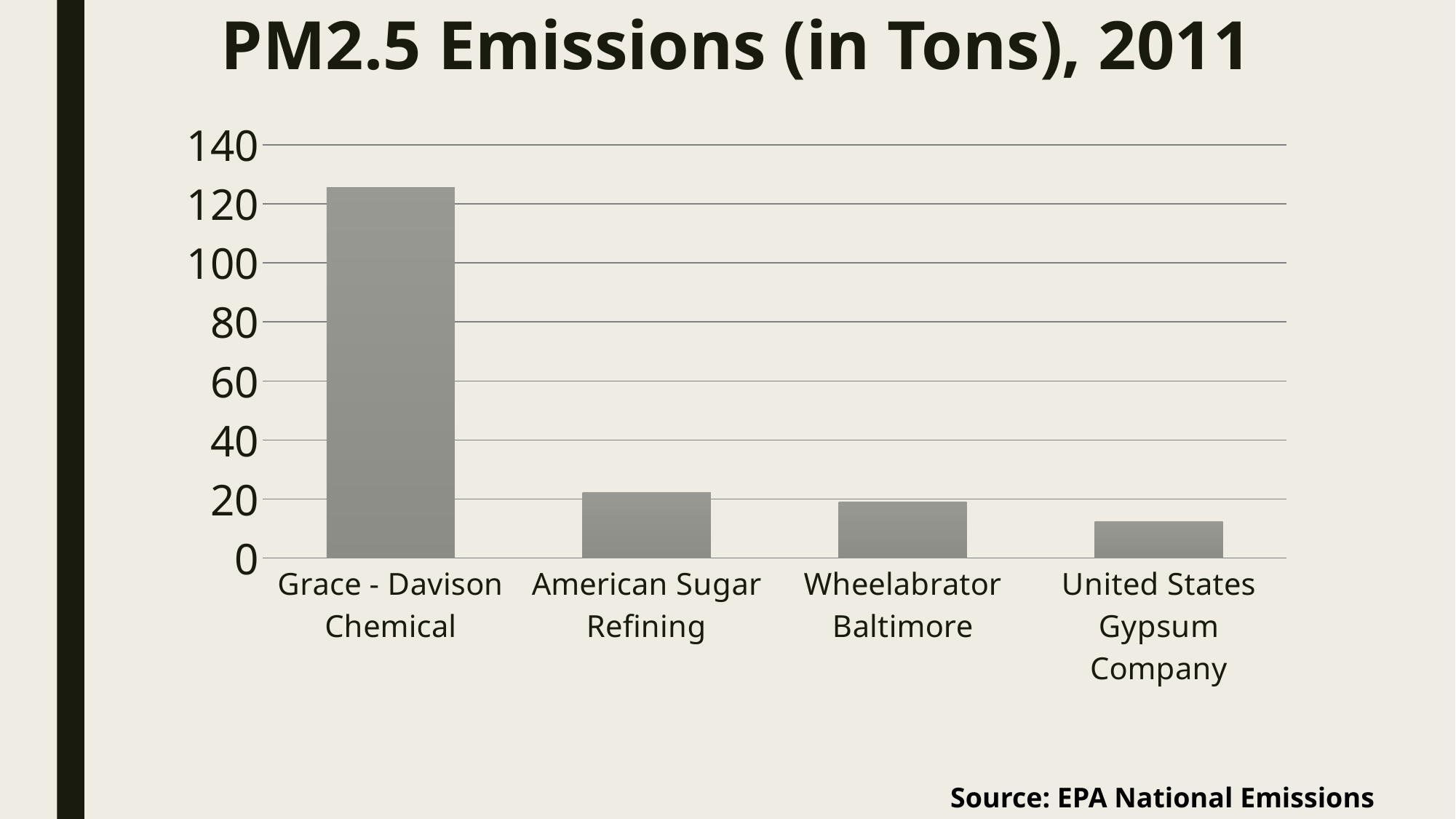
Do the values rise or fall from left to right across the chart? fall Which facility has the highest PM2.5 emissions? Grace - Davison Chemical Which has higher PM2.5 emissions, Grace - Davison Chemical or American Sugar Refining? Grace - Davison Chemical How many facilities are shown on the chart? 4 Is the value for American Sugar Refining greater or less than 40? less Is the value for Grace - Davison Chemical greater or less than 100? greater Is the value for United States Gypsum Company greater or less than 20? less Which has higher PM2.5 emissions, Wheelabrator Baltimore or United States Gypsum Company? Wheelabrator Baltimore What type of chart is shown on the slide? bar chart Which facility has the lowest PM2.5 emissions? United States Gypsum Company What is the title of the chart? PM2.5 Emissions (in Tons), 2011